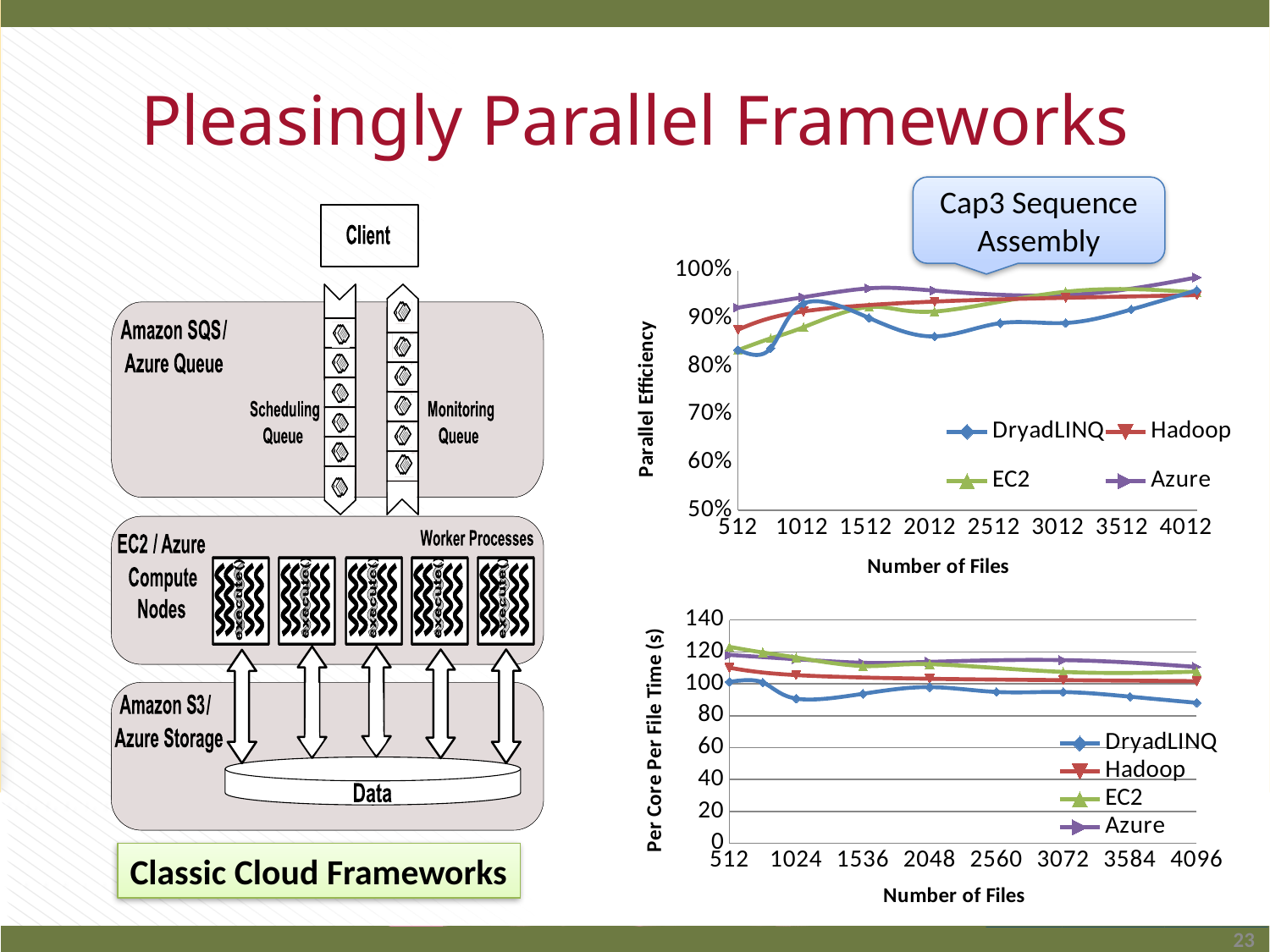
What kind of chart is the bottom chart on the right (Per Core Per File Time)? line chart In the bottom chart (Per Core Per File Time), which series has the lowest value at 4096 files? DryadLINQ In the bottom chart (Per Core Per File Time), which is larger at 512 files: EC2 or DryadLINQ? EC2 In the top chart (Parallel Efficiency), which series has the highest value at 512 files? Azure In the bottom chart (Per Core Per File Time), is the value for DryadLINQ at 4096 files greater or less than 100? less In the top chart (Parallel Efficiency), is the value for Azure at 512 files greater or less than 90%? greater In the top chart (Parallel Efficiency), is the value for DryadLINQ at 2012 files greater or less than 90%? less What kind of chart is the top chart on the right (Parallel Efficiency)? line chart How many series does the legend of the top chart (Parallel Efficiency) list? 4 What is the y-axis title of the bottom chart on the right? Per Core Per File Time (s) In the top chart (Parallel Efficiency), does the Azure series generally rise or fall from 512 to 4012 files? rise